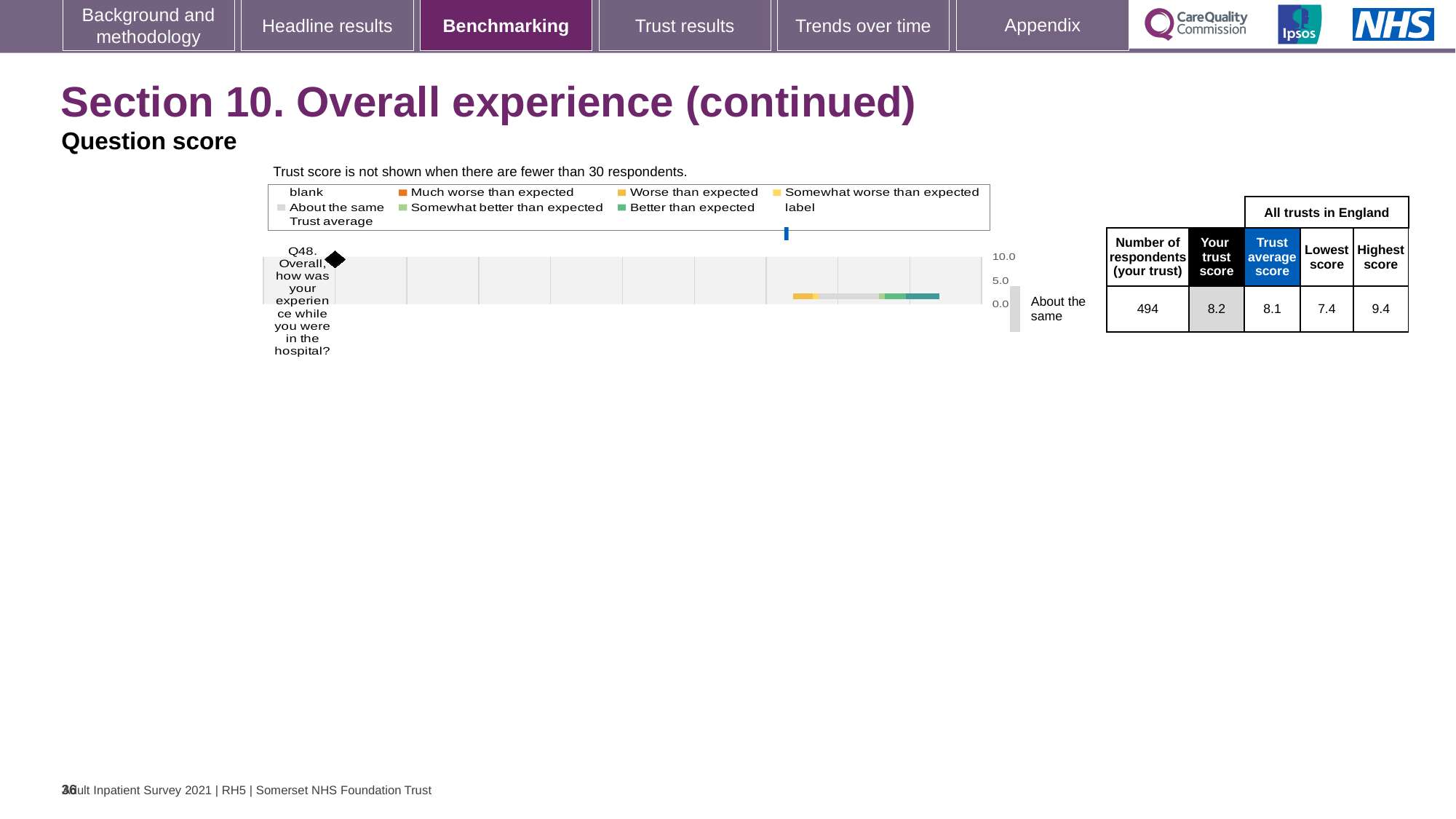
How many questions are plotted in the benchmarking chart on this slide? 1 What is the trust average score across all trusts in England for Q48? 8.1 What is the difference between the highest and lowest scores among all trusts in England for Q48? 2.0 Which is larger for Q48: your trust score or the trust average score? Your trust score What is the highest score among all trusts in England for Q48? 9.4 What is the 'Your trust score' for Q48 (Overall, how was your experience while you were in the hospital?)? 8.2 What kind of chart is used to show the Q48 benchmarking result? Bar chart What is the difference between your trust score and the trust average score for Q48? 0.1 What is the lowest score among all trusts in England for Q48? 7.4 How many respondents from your trust answered Q48? 494 How is your trust's result for Q48 categorised relative to expectations? About the same Is your trust score for Q48 greater or less than 5.0? greater